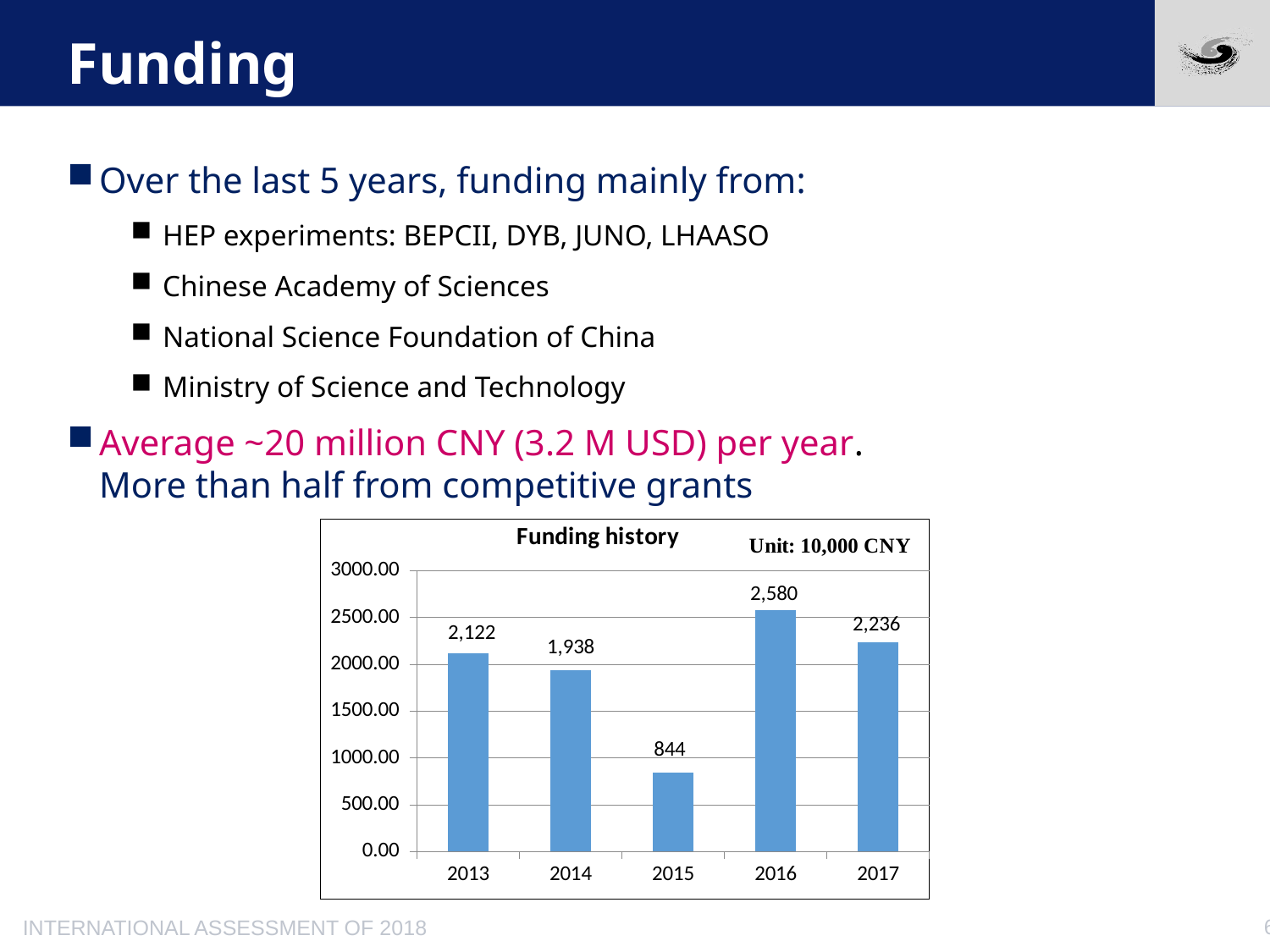
What is the value for 2015 in the Funding history chart? 844 Which year has the highest value in the Funding history chart? 2016 Which year has the lowest value in the Funding history chart? 2015 What is the value for 2013 in the Funding history chart? 2,122 What kind of chart is the Funding history chart? bar chart What is the value for 2017 in the Funding history chart? 2,236 Which is larger in the Funding history chart, the value for 2017 or the value for 2014? 2017 Is the value for 2016 in the Funding history chart greater or less than 2500.00? greater What is the difference between the values for 2013 and 2014 in the Funding history chart? 184 What unit is stated for the values in the Funding history chart? 10,000 CNY How many years are shown in the Funding history chart? 5 What is the difference between the values for 2016 and 2015 in the Funding history chart? 1,736